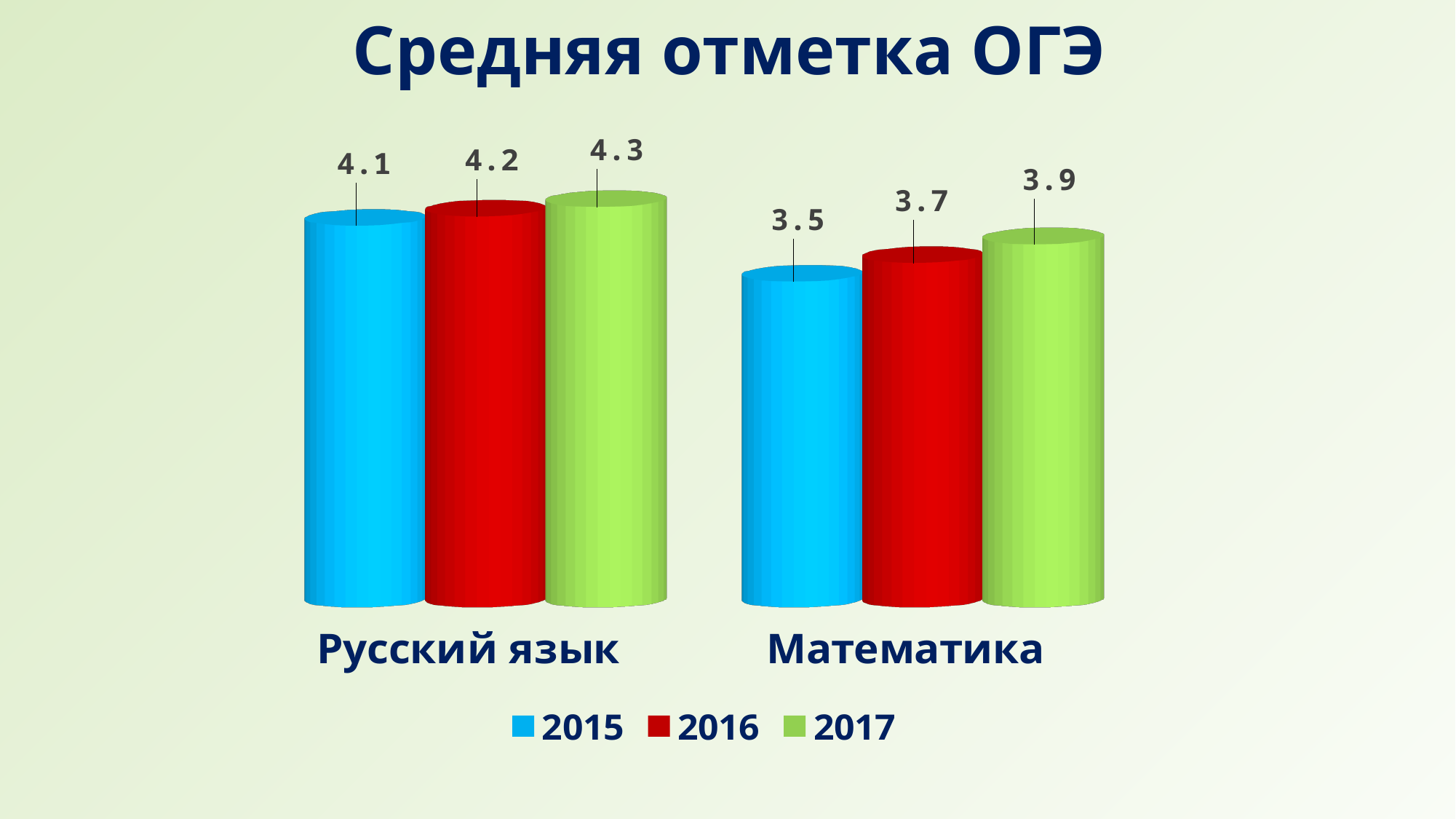
What kind of chart is shown on the slide? Bar chart What is the difference between the 2017 and 2015 values for Математика? 0.4 What is the difference between the Русский язык and Математика values in 2016? 0.5 How many categories are shown on the x axis? 2 What is the value for Математика in 2016? 3.7 How many series does the legend list? 3 What is the value for Русский язык in 2015? 4.1 Which year has the lowest value for Математика? 2015 Which year has the highest value for Русский язык? 2017 Which is larger: the 2017 value for Математика or the 2015 value for Русский язык? 2015 value for Русский язык What is the title of the chart? Средняя отметка ОГЭ What is the value for Математика in 2017? 3.9